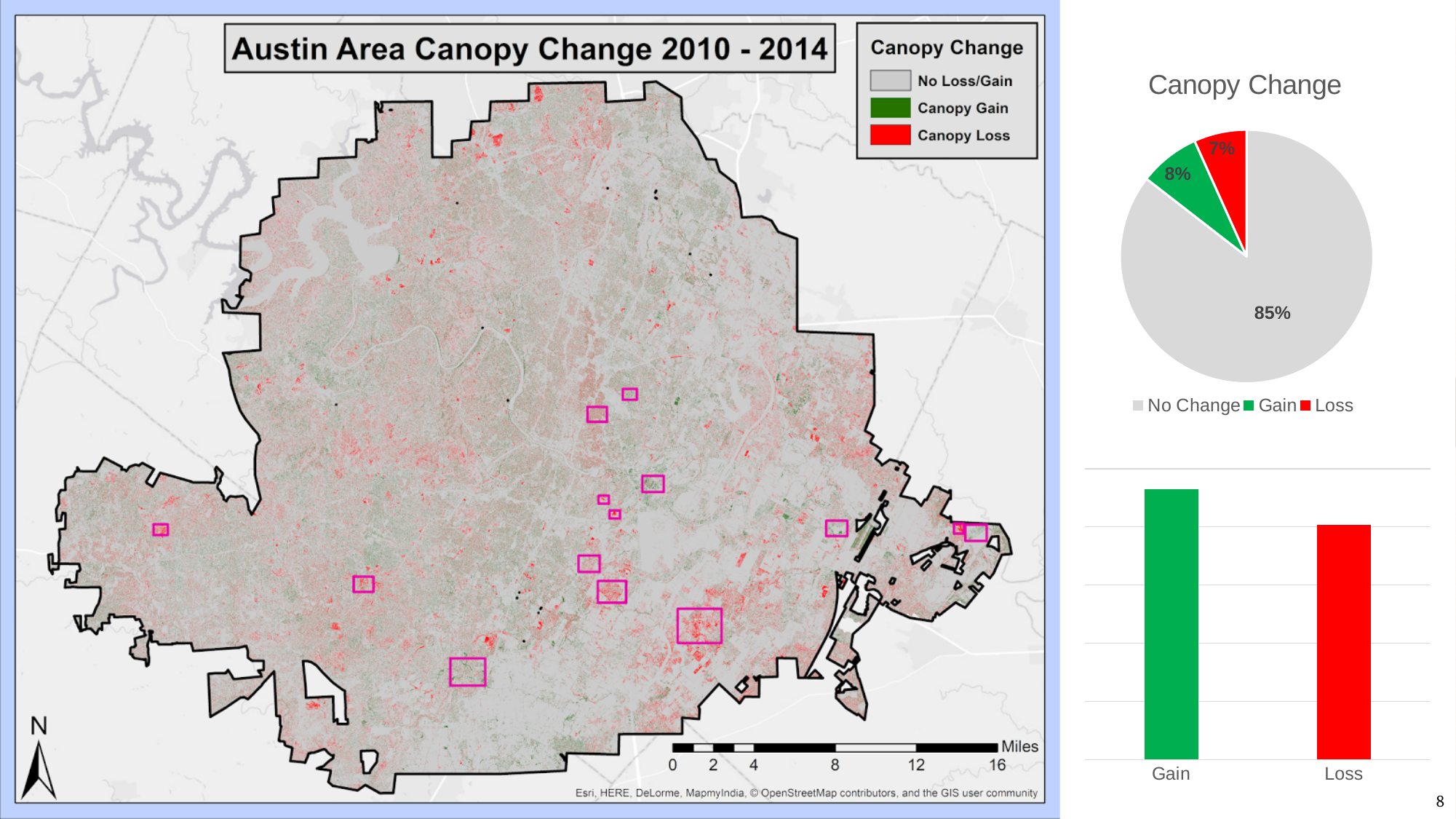
In the pie chart titled Canopy Change, which category has the smallest slice? Loss In the pie chart titled Canopy Change, how many slices are there? 3 In the bar chart at the bottom right of the slide, how many bars are there? 2 In the pie chart titled Canopy Change, what share is labelled Gain? 8% In the pie chart titled Canopy Change, what colour is the Gain slice? Green In the bar chart at the bottom right of the slide, which bar is taller, Gain or Loss? Gain What kind of chart is shown at the bottom right of the slide, with the categories Gain and Loss? Bar chart In the pie chart titled Canopy Change, which category has the largest slice? No Change In the pie chart titled Canopy Change, what share is labelled Loss? 7% In the pie chart titled Canopy Change, how many entries does the legend list? 3 In the pie chart titled Canopy Change, what is the difference in percentage points between the Gain and Loss slices? 1% In the pie chart titled Canopy Change, what share is labelled No Change? 85%